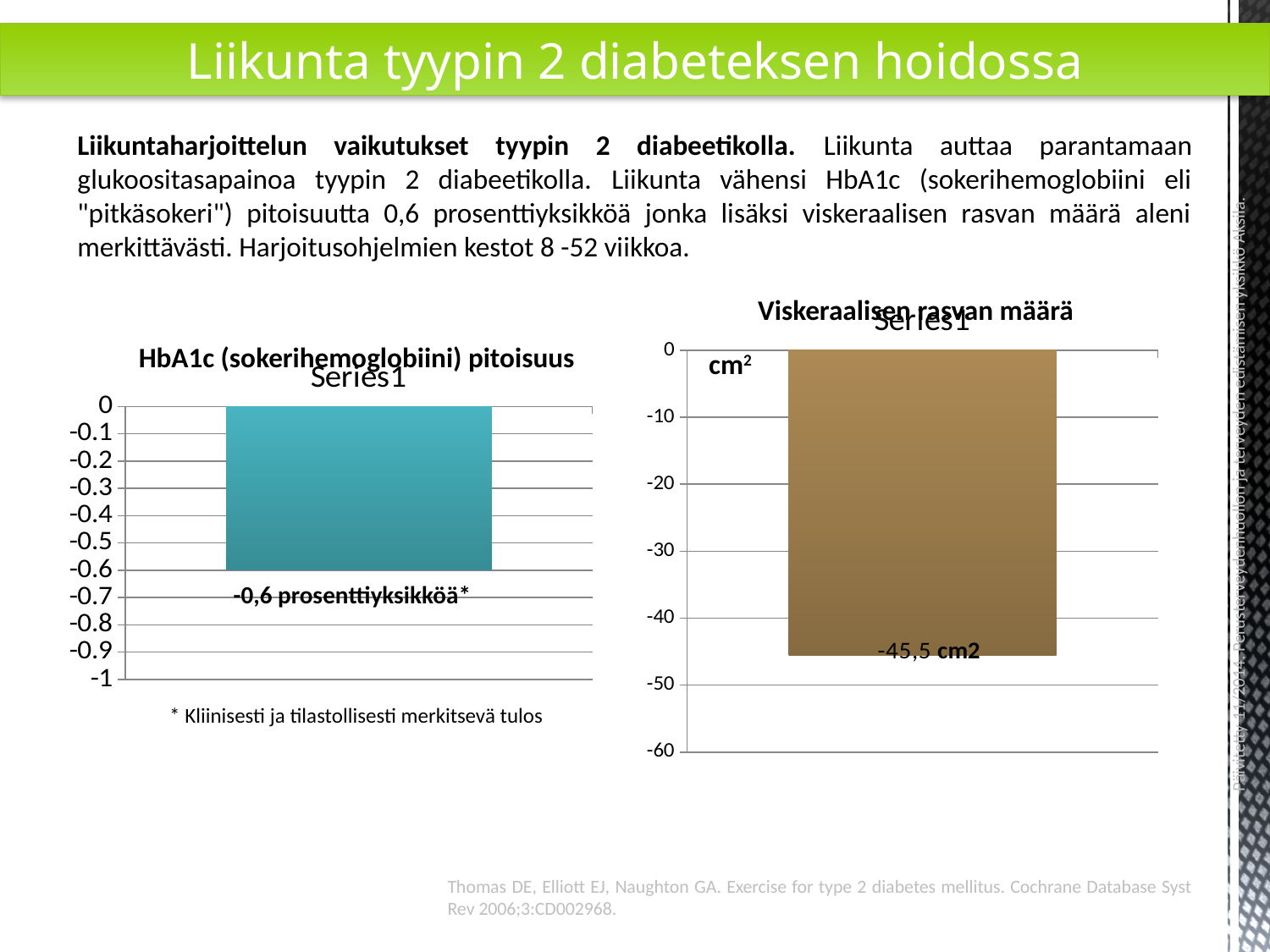
In the left chart, "HbA1c (sokerihemoglobiini) pitoisuus", is the value of the bar greater or less than -0.5? less In the chart titled "Viskeraalisen rasvan määrä", what value is printed on the bar's data label? -45,5 cm2 How many bars are plotted in the left chart, "HbA1c (sokerihemoglobiini) pitoisuus"? 1 How many bars are plotted in the right chart, "Viskeraalisen rasvan määrä"? 1 In the right chart, "Viskeraalisen rasvan määrä", is the value of the bar greater or less than -40? less In the chart titled "HbA1c (sokerihemoglobiini) pitoisuus", what value is printed on the bar's data label? -0,6 prosenttiyksikköä* What is the lowest tick value shown on the vertical axis of the right chart, "Viskeraalisen rasvan määrä"? -60 What kind of chart is the left chart, "HbA1c (sokerihemoglobiini) pitoisuus"? bar chart What kind of chart is the right chart, "Viskeraalisen rasvan määrä"? bar chart What unit is printed near the top of the vertical axis in the right chart, "Viskeraalisen rasvan määrä"? cm²